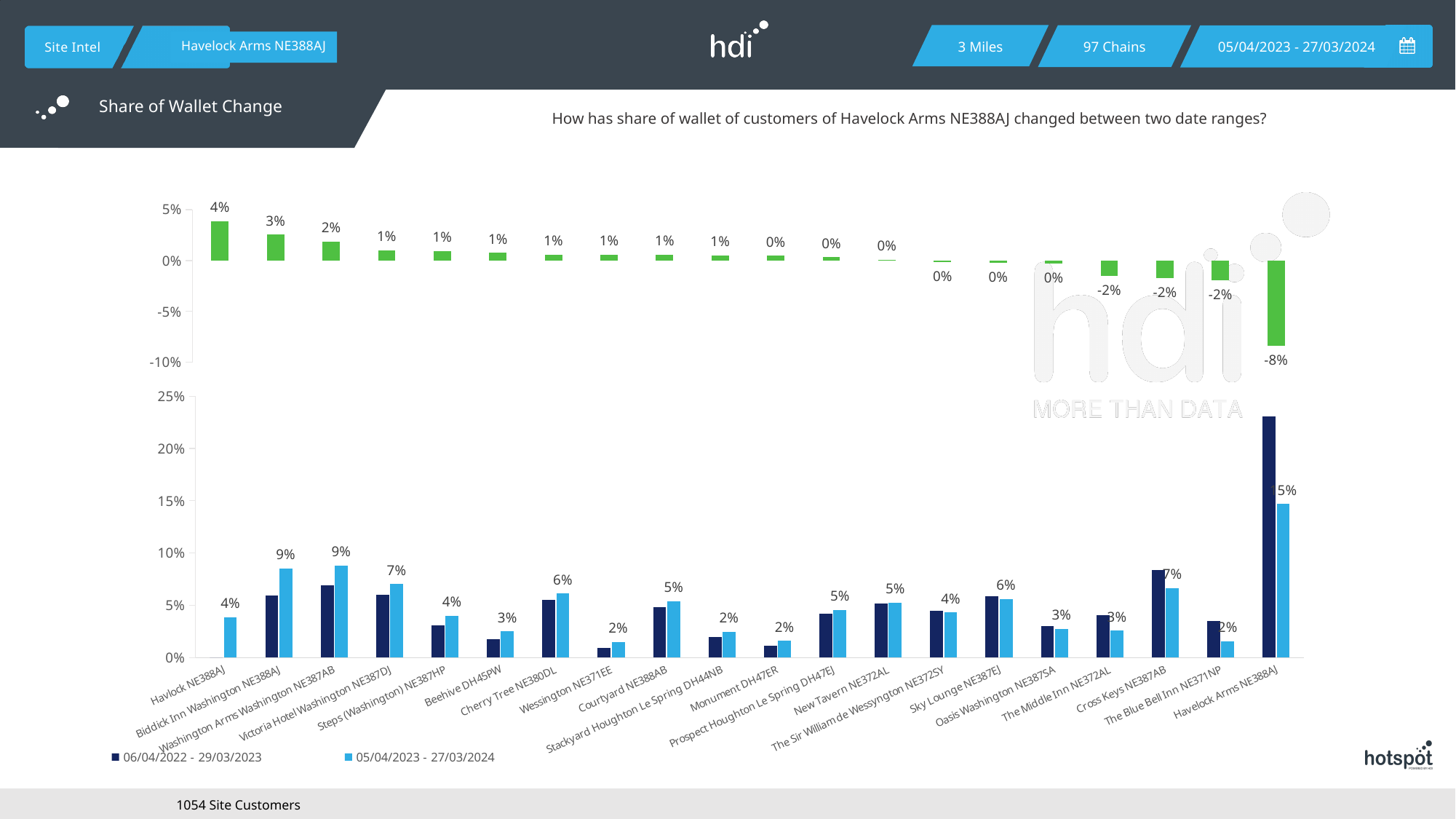
In the bottom chart, what is the 05/04/2023 - 27/03/2024 value for Havelock Arms NE388AJ? 15% In the top chart (share of wallet change), what is the value for Havlock NE388AJ? 4% In the top chart (share of wallet change), what is the difference between the values for Havlock NE388AJ and Biddick Inn Washington NE388AJ? 1% What kind of chart is the bottom chart? bar chart In the bottom chart, for Cross Keys NE387AB, which series has the larger value? 06/04/2022 - 29/03/2023 In the top chart (share of wallet change), which category has the highest value? Havlock NE388AJ In the top chart (share of wallet change), what is the value for Cross Keys NE387AB? -2% In the top chart (share of wallet change), what is the value for Havelock Arms NE388AJ? -8% In the top chart (share of wallet change), which category has the lowest value? Havelock Arms NE388AJ In the bottom chart, what is the 05/04/2023 - 27/03/2024 value for Biddick Inn Washington NE388AJ? 9% In the bottom chart, is the 06/04/2022 - 29/03/2023 value for Havelock Arms NE388AJ greater or less than 20%? greater In the bottom chart, how many series does the legend list? 2